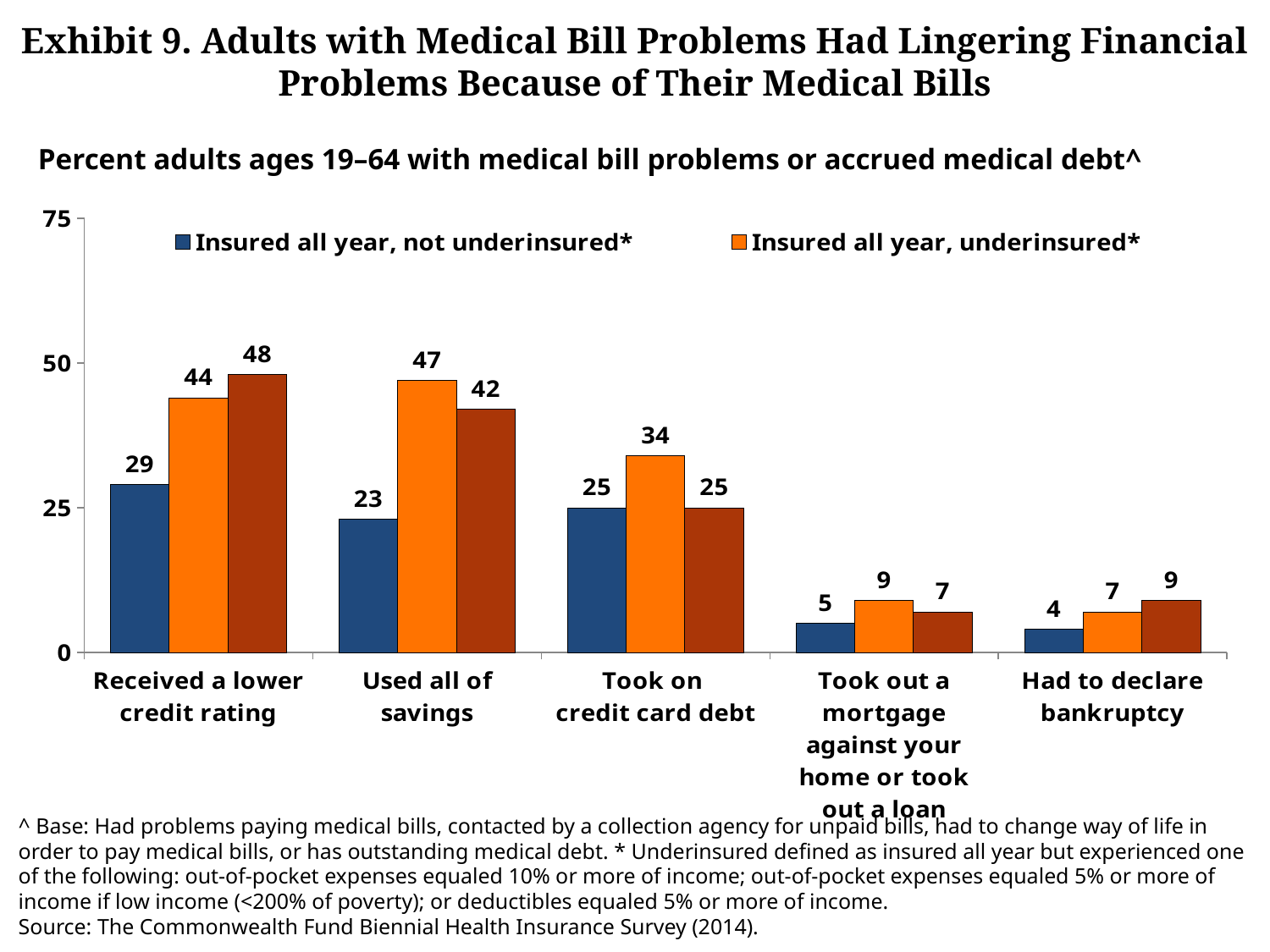
What is the value for "Used all of savings" in the "Insured all year, underinsured*" series? 47 What is the value for "Received a lower credit rating" in the "Insured all year, not underinsured*" series? 29 Which category has the lowest value in the "Insured all year, not underinsured*" series? Had to declare bankruptcy For "Took out a mortgage against your home or took out a loan", which is larger: the "Insured all year, not underinsured*" value or the "Insured all year, underinsured*" value? Insured all year, underinsured* Is the "Insured all year, not underinsured*" value for "Received a lower credit rating" greater or less than 25? greater What is the difference between the "Insured all year, underinsured*" and "Insured all year, not underinsured*" values for "Used all of savings"? 24 What is the value for "Took on credit card debt" in the "Insured all year, underinsured*" series? 34 What kind of chart is shown on the slide? bar chart What is the value for "Had to declare bankruptcy" in the "Insured all year, not underinsured*" series? 4 Which category has the highest value in the "Insured all year, underinsured*" series? Used all of savings How many series does the legend list? 2 How many categories are shown on the x axis? 5